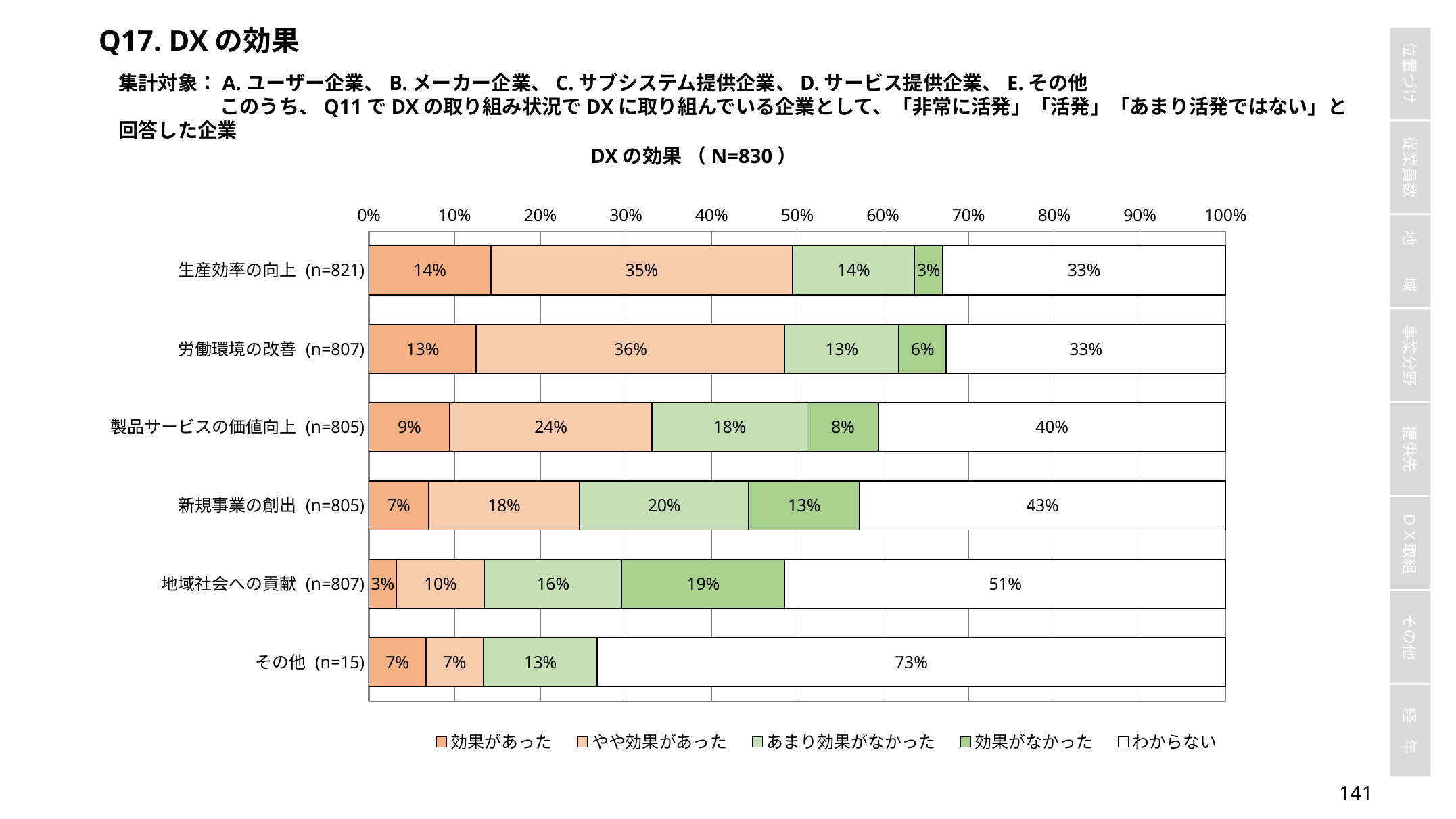
How many series does the legend list? 5 Which category has the highest value for 効果があった? 生産効率の向上 (n=821) What is the title of the chart? DX の効果 （ N=830 ） What type of chart is shown on the slide? Stacked bar chart What is the value of 効果がなかった for 地域社会への貢献 (n=807)? 19% How many categories are plotted on the chart? 6 What is the value of やや効果があった for 労働環境の改善 (n=807)? 36% What is the value of わからない for その他 (n=15)? 73% What is the difference between the わからない values for 地域社会への貢献 (n=807) and 生産効率の向上 (n=821)? 18% Which category has the lowest value for 効果があった? 地域社会への貢献 (n=807) What is the combined value of 効果があった and やや効果があった for 生産効率の向上 (n=821)? 49% Which is larger: あまり効果がなかった for 新規事業の創出 (n=805) or for 製品サービスの価値向上 (n=805)? 新規事業の創出 (n=805)